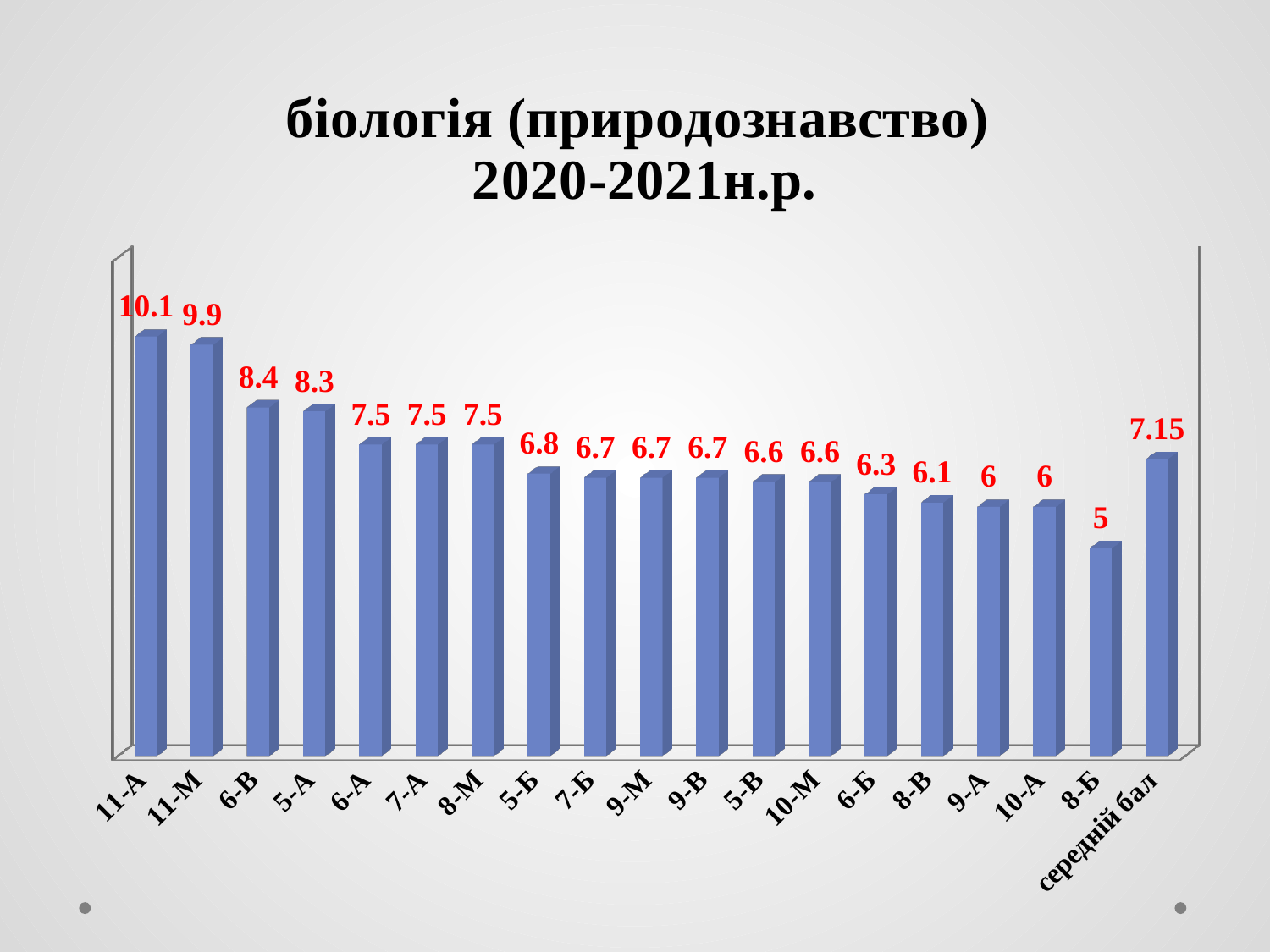
What is the value for 11-А? 10.1 Which class has the highest value? 11-А What is the value for 8-Б? 5 What is the value for 6-Б? 6.3 How many bars are shown in the chart? 19 What is the difference between the values for 6-В and 5-А? 0.1 Which is larger, the value for 11-М or the value for 6-В? 11-М What is the value shown for середній бал? 7.15 Which category has the lowest value? 8-Б What is the title of the chart? біологія (природознавство) 2020-2021н.р. What kind of chart is shown on the slide? bar chart What is the difference between the values for 11-А and 8-Б? 5.1